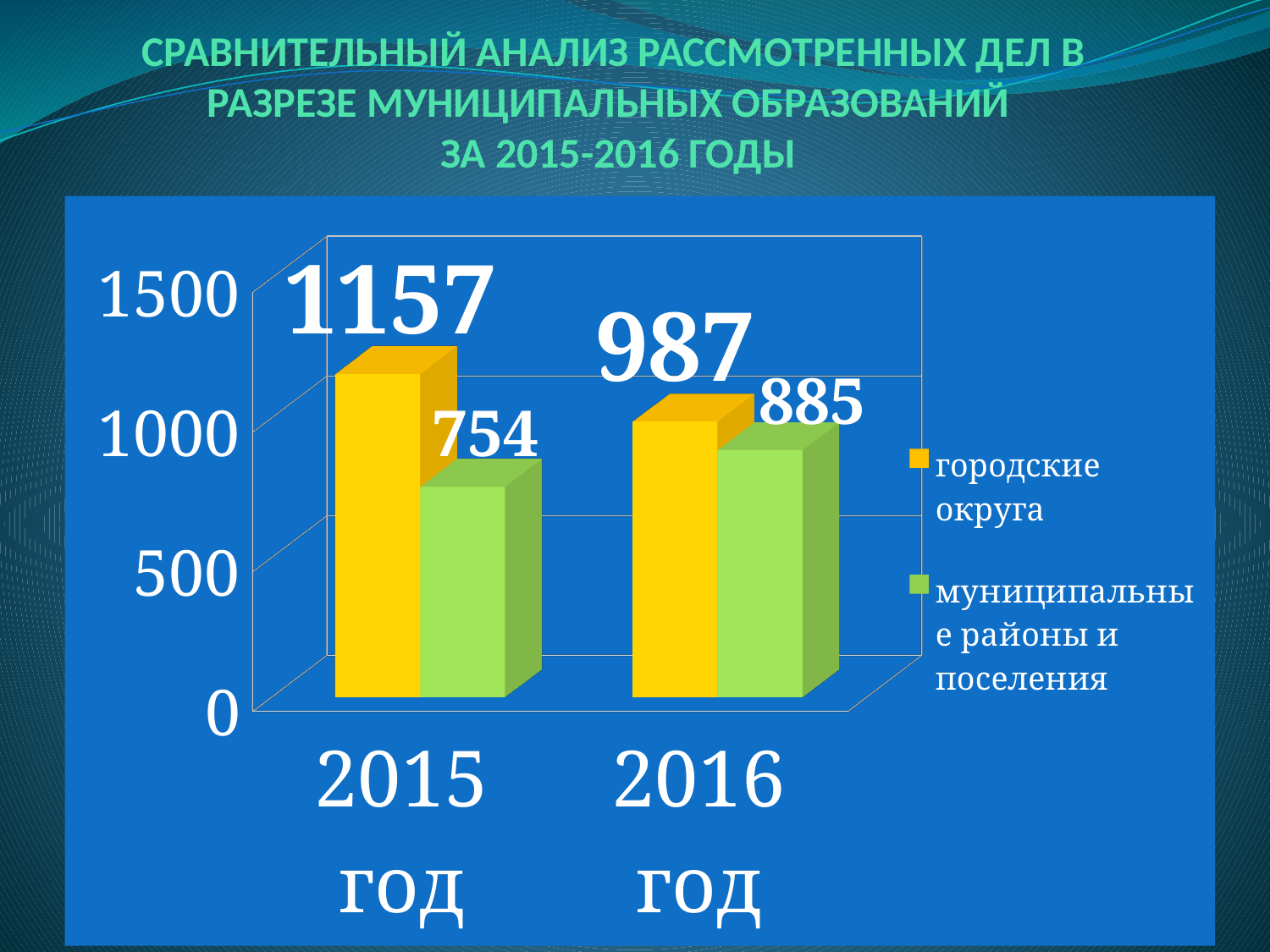
What is the value for муниципальные районы и поселения in 2015 год? 754 Which year has the highest value for городские округа? 2015 год What kind of chart is shown on the slide? bar chart Which year has the lowest value for муниципальные районы и поселения? 2015 год By how much did the value for городские округа change from 2015 год to 2016 год? 170 What is the value for муниципальные районы и поселения in 2016 год? 885 What is the value for городские округа in 2016 год? 987 How many series does the legend list? 2 What is the difference between городские округа and муниципальные районы и поселения in 2015 год? 403 Does the value for муниципальные районы и поселения rise or fall from 2015 год to 2016 год? rise What is the value for городские округа in 2015 год? 1157 Which is larger in 2016 год: городские округа or муниципальные районы и поселения? городские округа